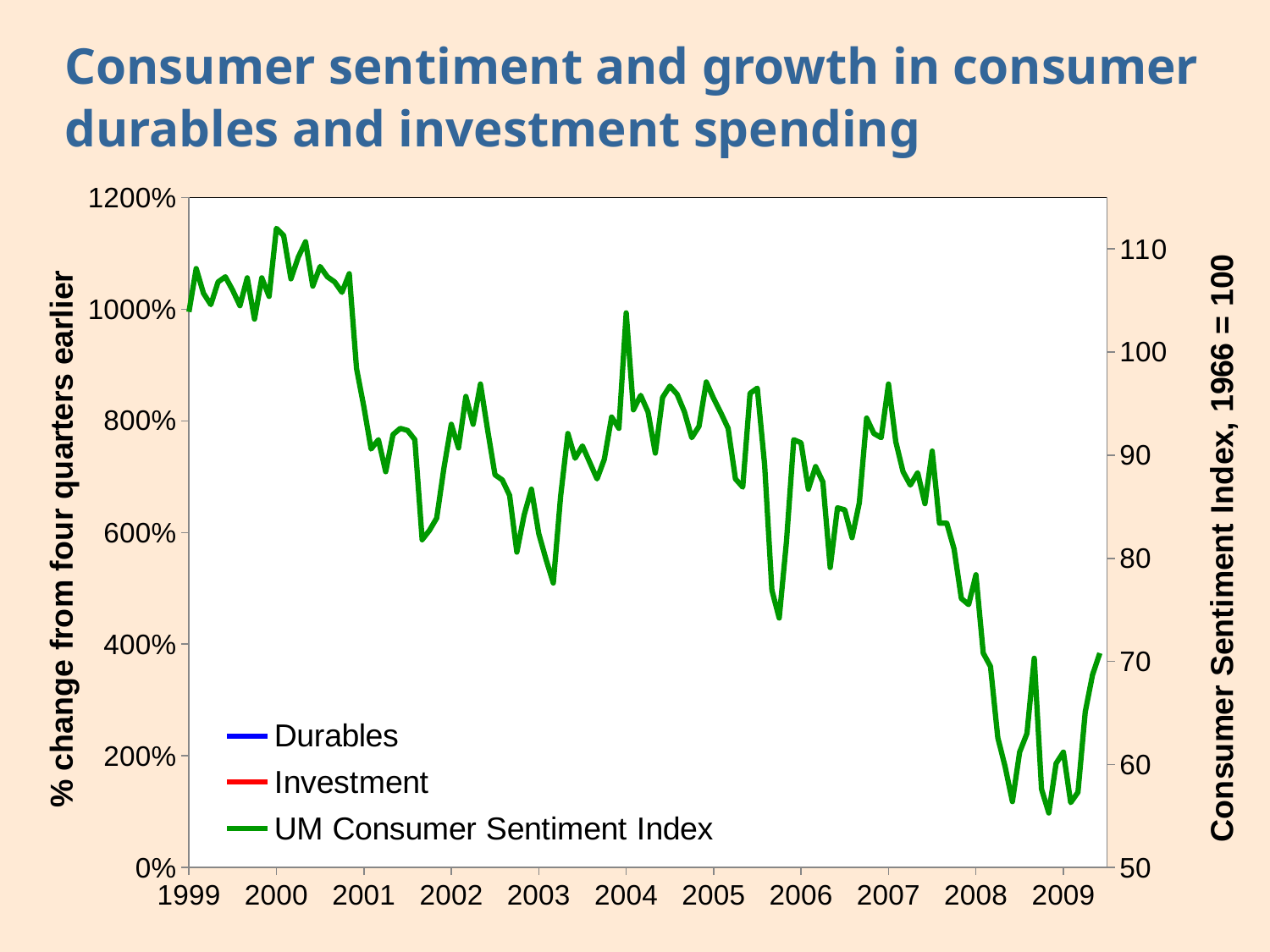
Is the UM Consumer Sentiment Index higher at the start of 1999 or at the end of 2009? start of 1999 What is the title of the right-hand vertical axis? Consumer Sentiment Index, 1966 = 100 Which series is drawn in green? UM Consumer Sentiment Index Is the lowest value of the UM Consumer Sentiment Index in late 2008 greater or less than 60 on the right axis? less In which year does the UM Consumer Sentiment Index reach its highest point? 2000 Does the UM Consumer Sentiment Index line overall rise or fall from 1999 to 2009? fall How many series does the legend list? 3 Is the UM Consumer Sentiment Index at the start of 2008 greater or less than 80 on the right axis? less Is the UM Consumer Sentiment Index at the start of 2006 greater or less than 80 on the right axis? greater What kind of chart is shown on the slide? line chart How many year labels are shown on the x axis? 11